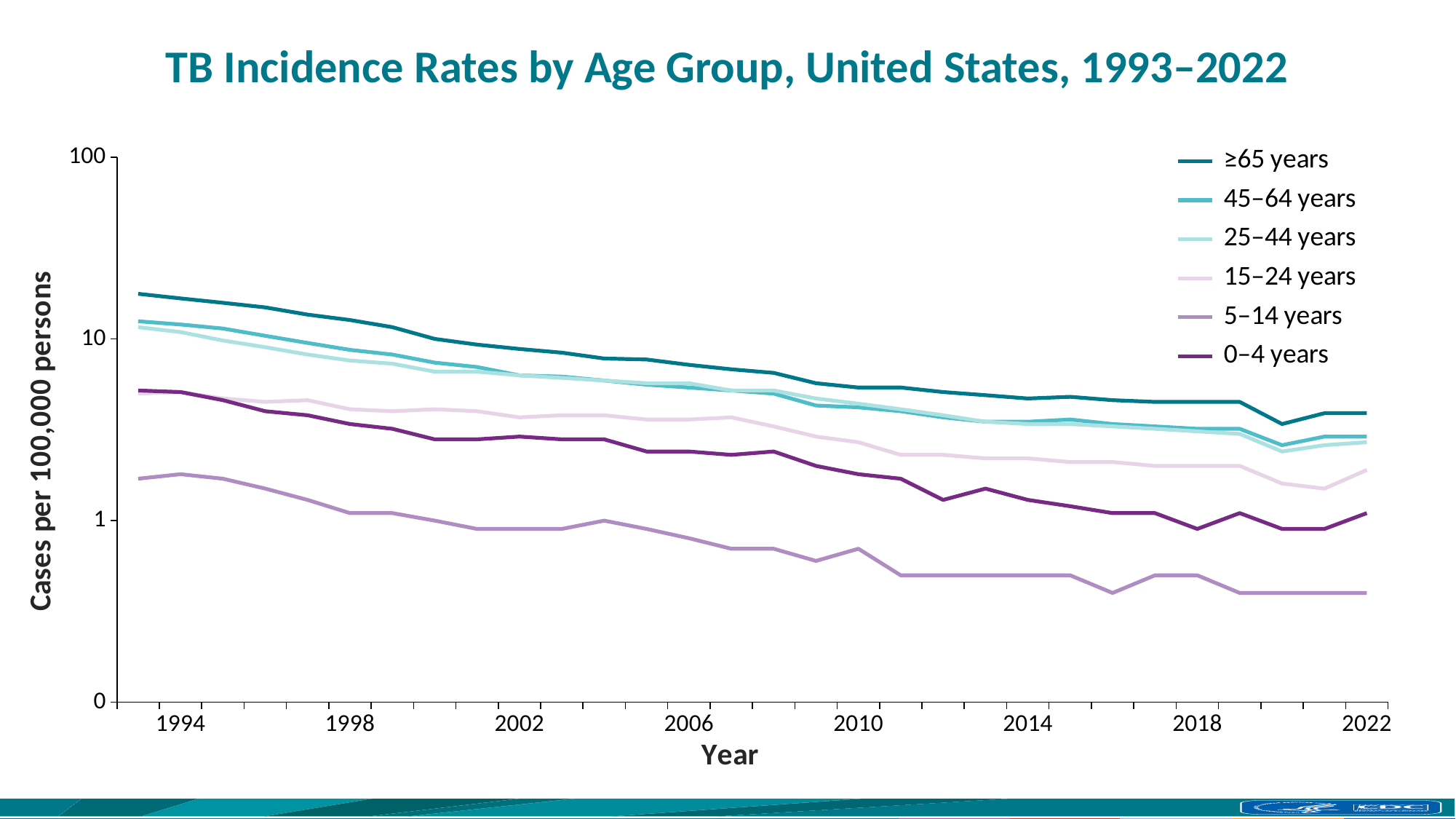
Which age group has the lowest TB incidence rate in 2022? 5–14 years Is the value for 0–4 years in 1994 greater or less than 1? greater Does the TB incidence rate for ≥65 years generally rise or fall from 1993 to 2022? fall What is the label of the y axis? Cases per 100,000 persons Is the value for 25–44 years in 2022 greater or less than 10? less What is the title of the chart? TB Incidence Rates by Age Group, United States, 1993–2022 Is the value for 5–14 years in 2022 greater or less than 1? less Which age group has the highest TB incidence rate in 2022? ≥65 years In 2010, which has the larger value: ≥65 years or 5–14 years? ≥65 years How many age groups does the legend list? 6 What kind of chart is shown on the slide? line chart